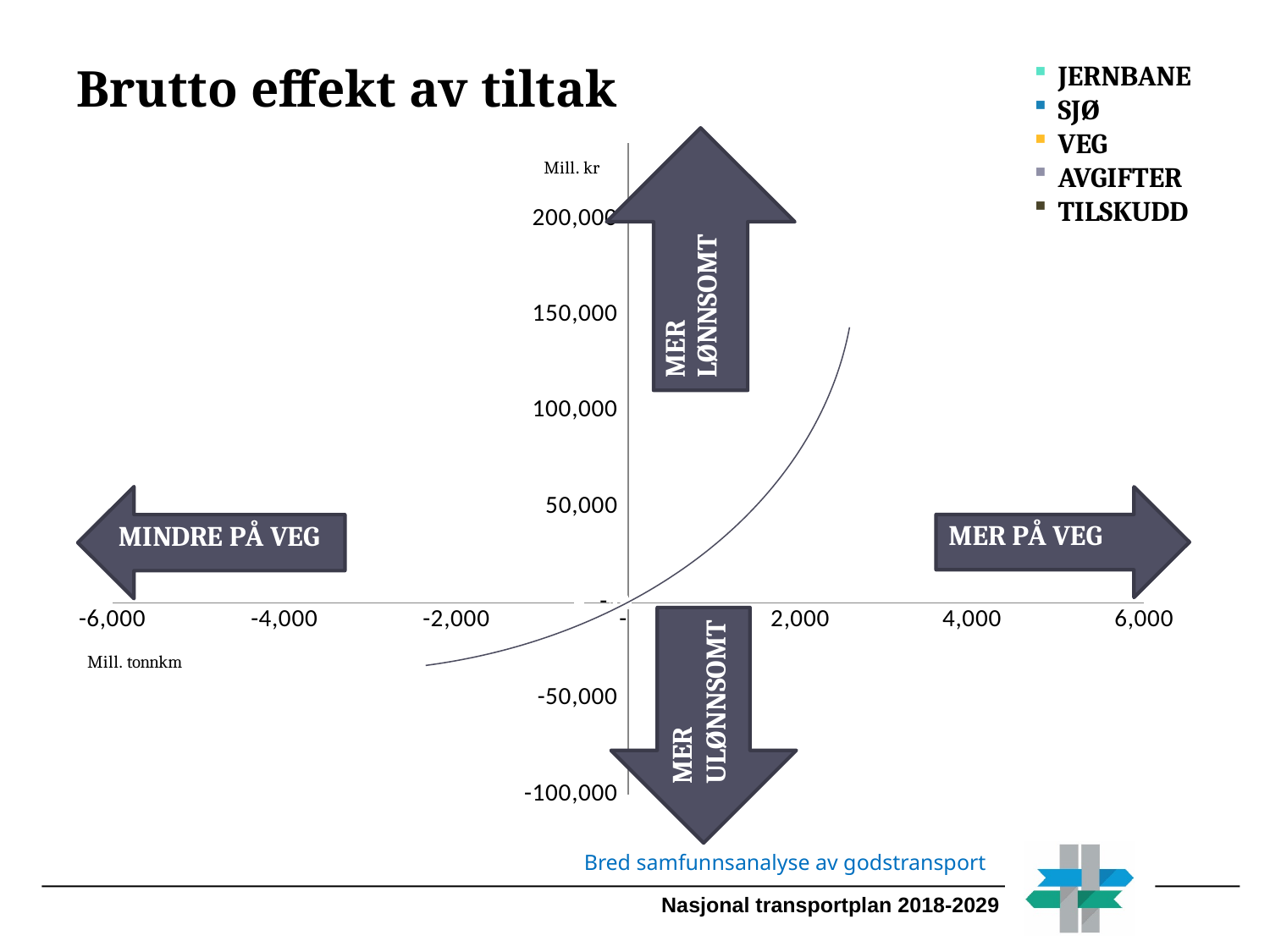
What kind of chart is shown on the slide? scatter chart How many series does the legend list? 5 Does the plotted curve rise or fall as you move from left to right along the x axis? rise What unit label is shown on the vertical axis of the chart? Mill. kr What is the title of the chart on the slide? Brutto effekt av tiltak